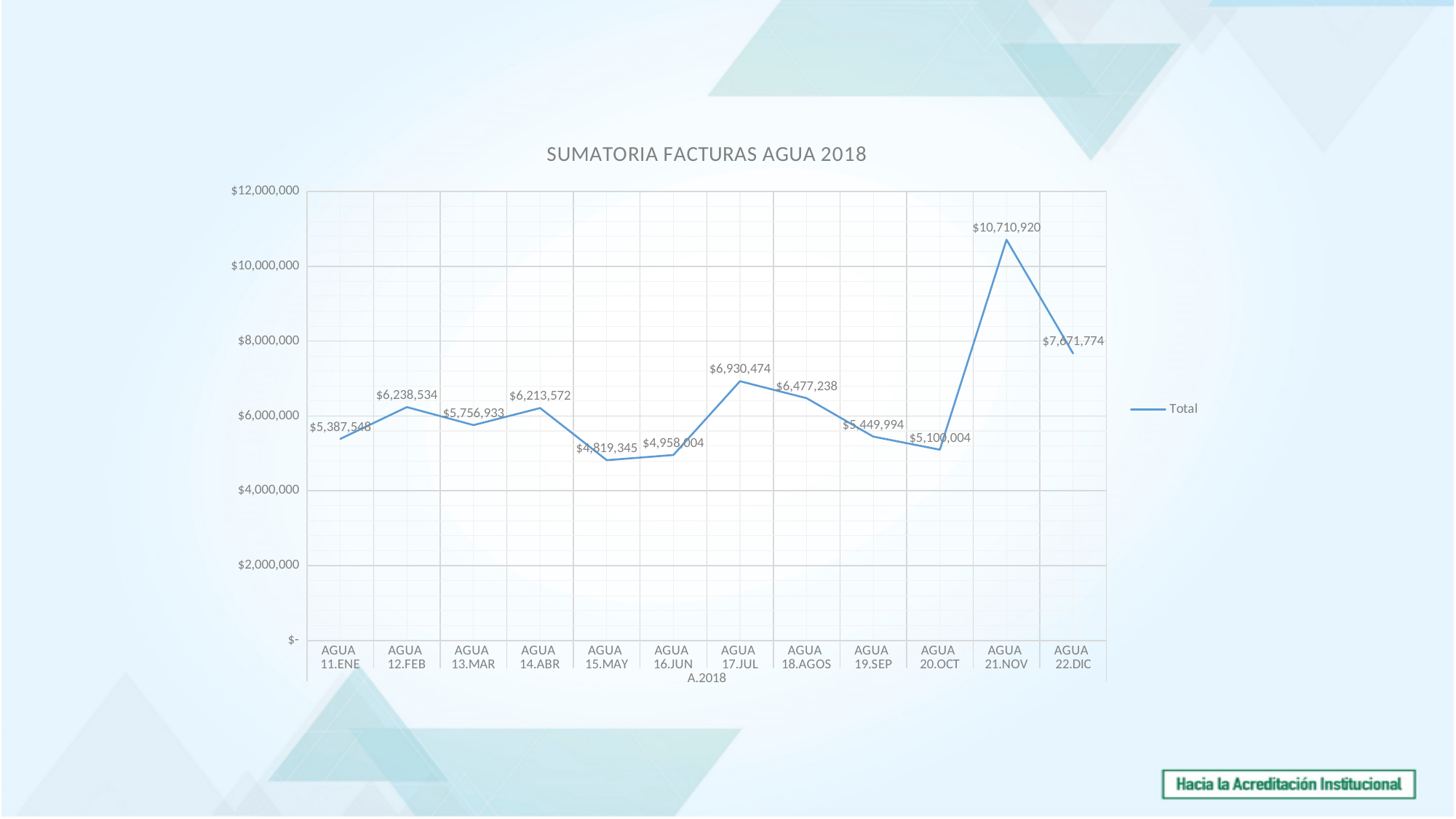
What type of chart is shown on the slide? Line chart Is the value for AGUA 22.DIC greater or less than $8,000,000? less What is the value for AGUA 21.NOV? $10,710,920 What is the value for AGUA 17.JUL? $6,930,474 What is the value for AGUA 15.MAY? $4,819,345 What is the difference between the values for AGUA 21.NOV and AGUA 22.DIC? $3,039,146 How many series does the legend list? 1 How many categories are plotted on the x axis? 12 Which category has the lowest value? AGUA 15.MAY Which category has the highest value? AGUA 21.NOV What is the title of the chart? SUMATORIA FACTURAS AGUA 2018 Which is larger, the value for AGUA 12.FEB or the value for AGUA 13.MAR? AGUA 12.FEB